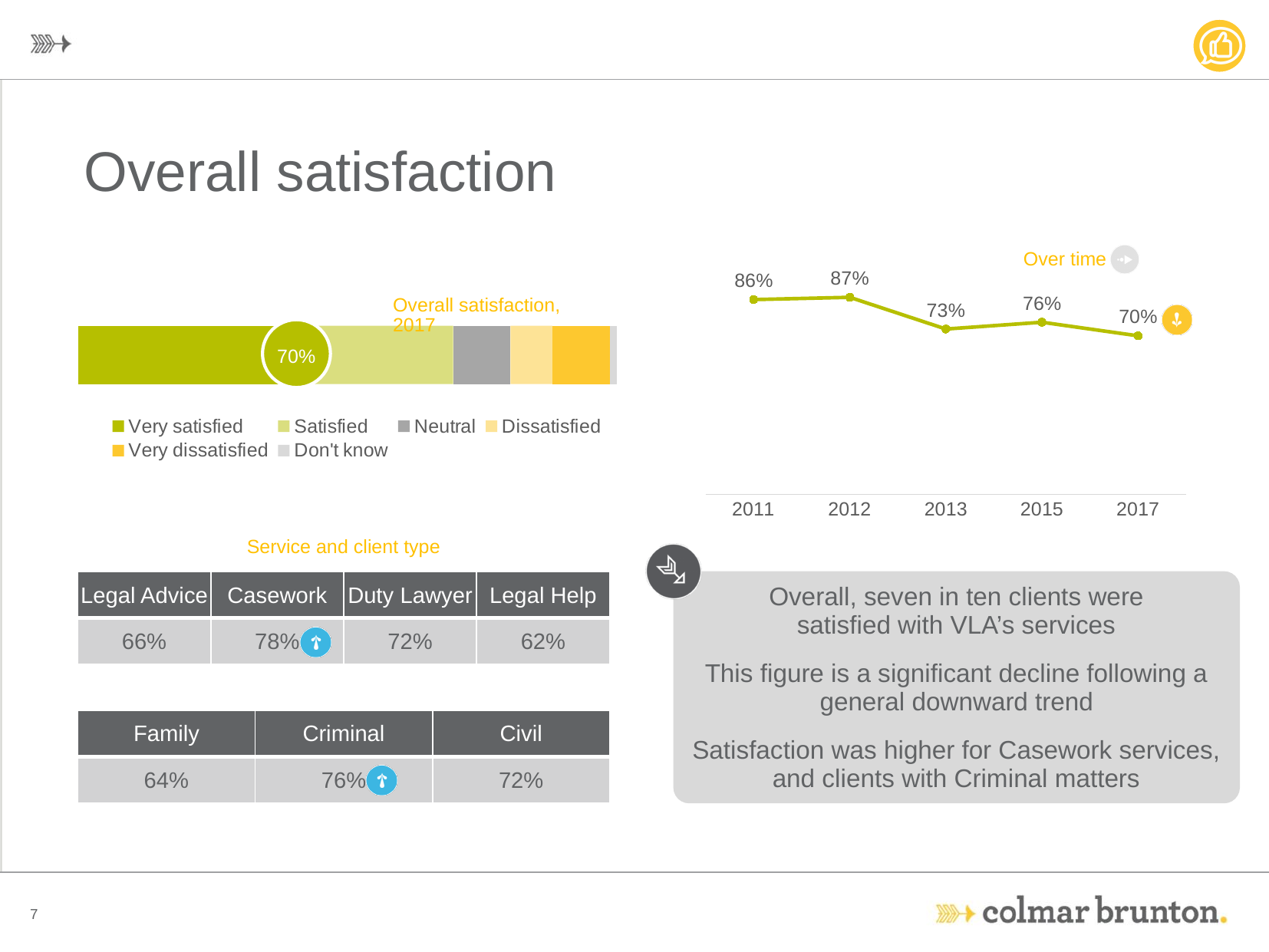
In the 'Over time' line chart, which year has the highest satisfaction value? 2012 In the 'Over time' line chart, what was the satisfaction value in 2013? 73% In the 'Over time' line chart, which is larger, the value for 2013 or the value for 2015? 2015 In the 'Over time' line chart, what is the difference between the 2011 value and the 2017 value? 16 percentage points What overall satisfaction value is labelled on the 'Overall satisfaction, 2017' bar chart? 70% In the 'Over time' line chart, what was the satisfaction value in 2015? 76% How many series does the legend of the 'Overall satisfaction, 2017' bar chart list? 6 What kind of chart is the 'Overall satisfaction, 2017' chart on the left? bar chart In the 'Over time' line chart, do the values generally rise or fall from 2011 to 2017? fall In the 'Over time' line chart, which year has the lowest satisfaction value? 2017 In the 'Over time' line chart, what was the satisfaction value in 2011? 86% How many years are plotted in the 'Over time' line chart? 5